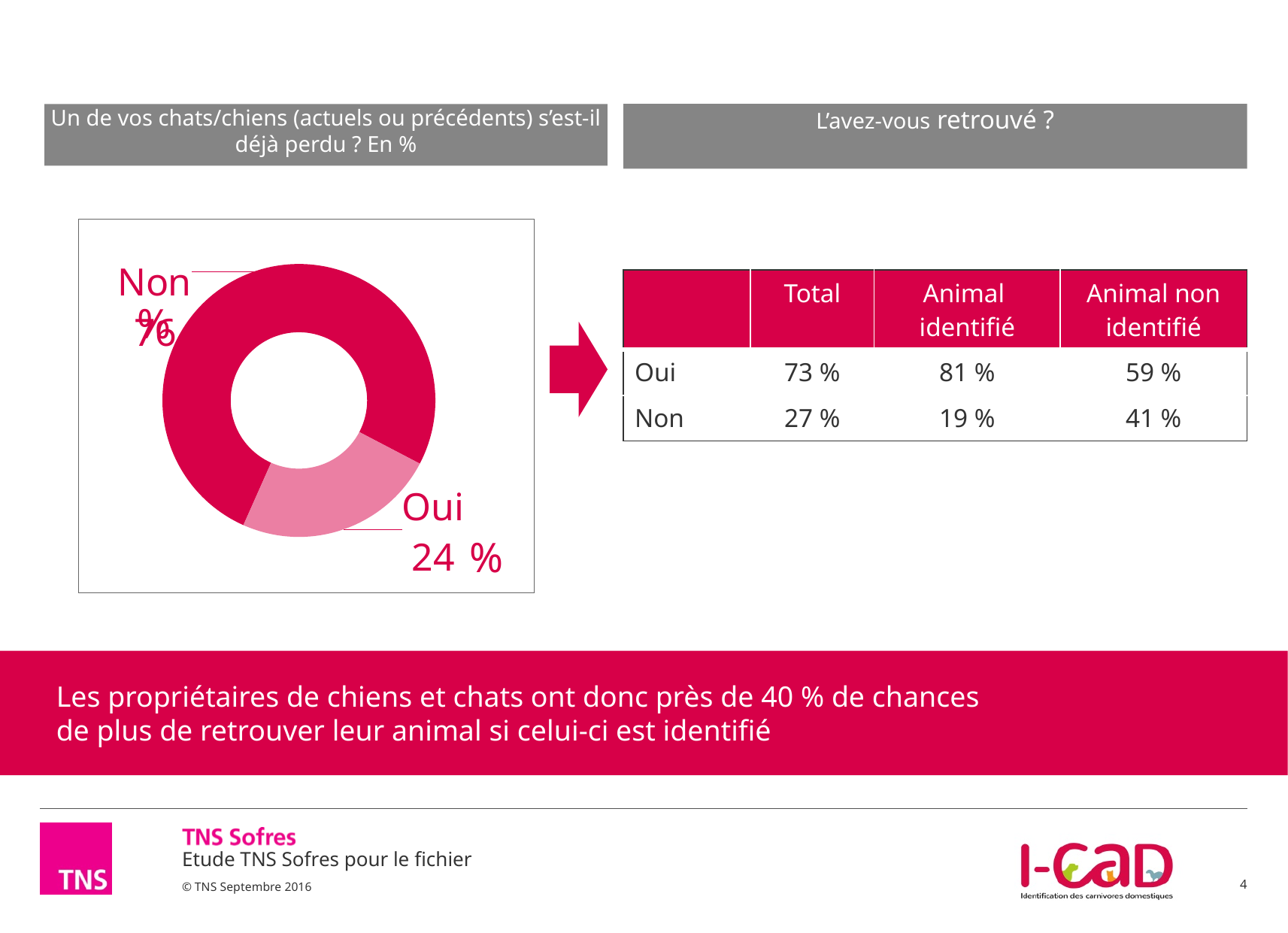
Which category has the smallest slice in the pie chart? Oui What is the title above the pie chart? Un de vos chats/chiens (actuels ou précédents) s'est-il déjà perdu ? En % How many categories does the pie chart have? 2 What kind of chart is shown on the left of the slide? pie chart (donut) Which slice of the pie chart is drawn in the lighter pink colour? Oui In the pie chart, which slice is larger, "Oui" or "Non"? Non Which category has the largest slice in the pie chart? Non In the pie chart, what is the value shown for "Oui"? 24 % What share of the pie chart does the "Oui" slice represent? 24 %